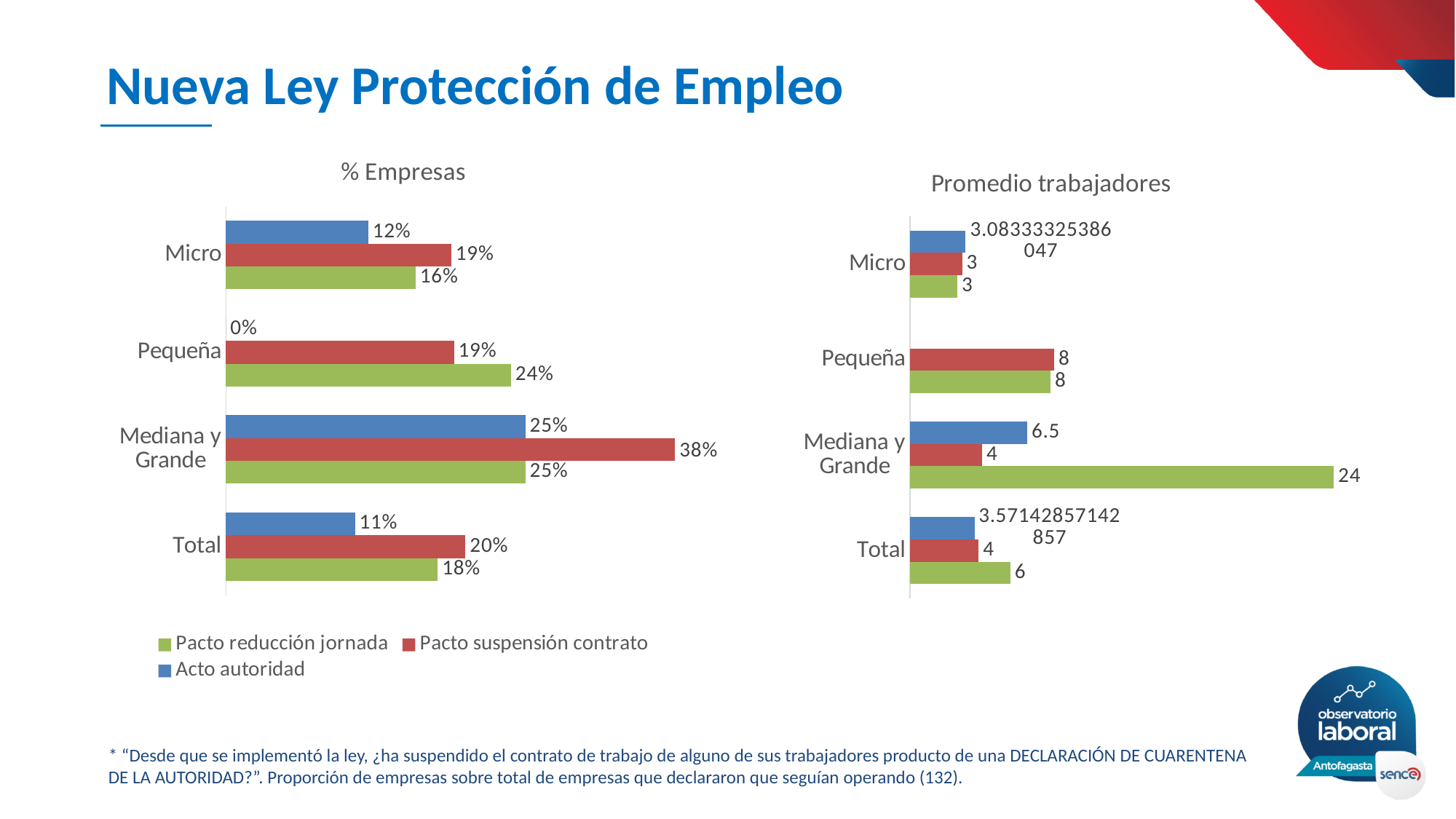
In the '% Empresas' chart, what is the difference between Pacto suspensión contrato and Acto autoridad for Micro? 7% In the '% Empresas' chart, what is the value of Acto autoridad for Pequeña? 0% In the '% Empresas' chart, which category has the highest value for Pacto suspensión contrato? Mediana y Grande In the '% Empresas' chart, what is the value of Pacto suspensión contrato for Mediana y Grande? 38% In the 'Promedio trabajadores' chart, what is the value of the red bar (Pacto suspensión contrato) for Pequeña? 8 In the '% Empresas' chart, what is the value of Pacto reducción jornada for Total? 18% What type of chart is the '% Empresas' chart? Bar chart In the 'Promedio trabajadores' chart, which category has the highest value for the green bar (Pacto reducción jornada)? Mediana y Grande In the '% Empresas' chart, which is larger for Pequeña: Pacto reducción jornada or Pacto suspensión contrato? Pacto reducción jornada In the 'Promedio trabajadores' chart, what is the value of the green bar (Pacto reducción jornada) for Mediana y Grande? 24 In the 'Promedio trabajadores' chart, what is the value of the blue bar (Acto autoridad) for Mediana y Grande? 6.5 How many series does the legend on the slide list? 3